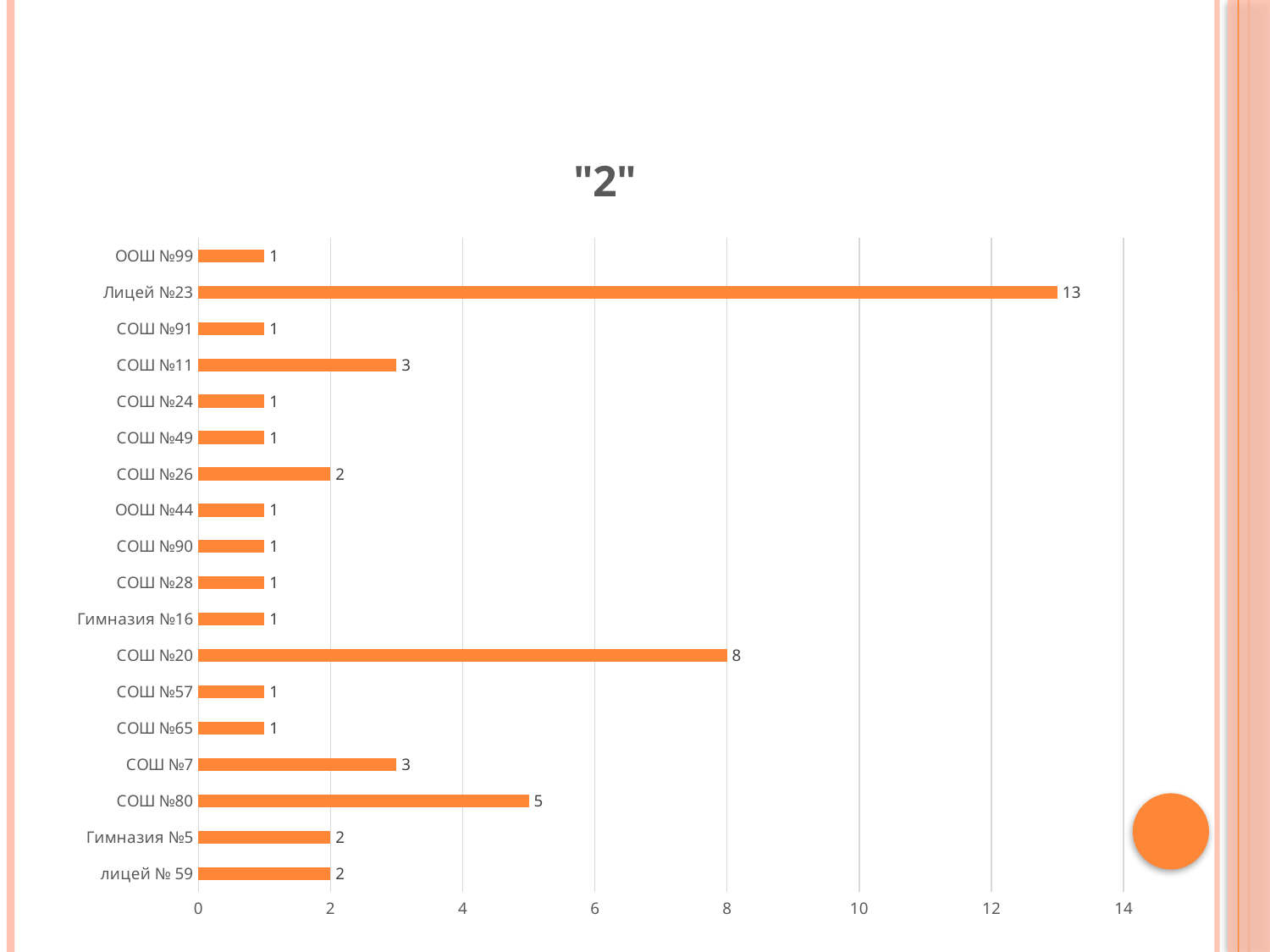
What is the difference between the values for Лицей №23 and СОШ №20? 5 What is the value for СОШ №80? 5 What kind of chart is shown on the slide? bar chart What is the difference between the values for СОШ №80 and СОШ №26? 3 What is the value for СОШ №7? 3 What is the title of the chart? "2" What is the value for СОШ №20? 8 Is the value for Лицей №23 greater or less than 12? greater How many categories are shown in the chart? 18 Which is larger, the value for СОШ №11 or the value for Гимназия №5? СОШ №11 What is the value for Лицей №23? 13 Which category has the highest value? Лицей №23